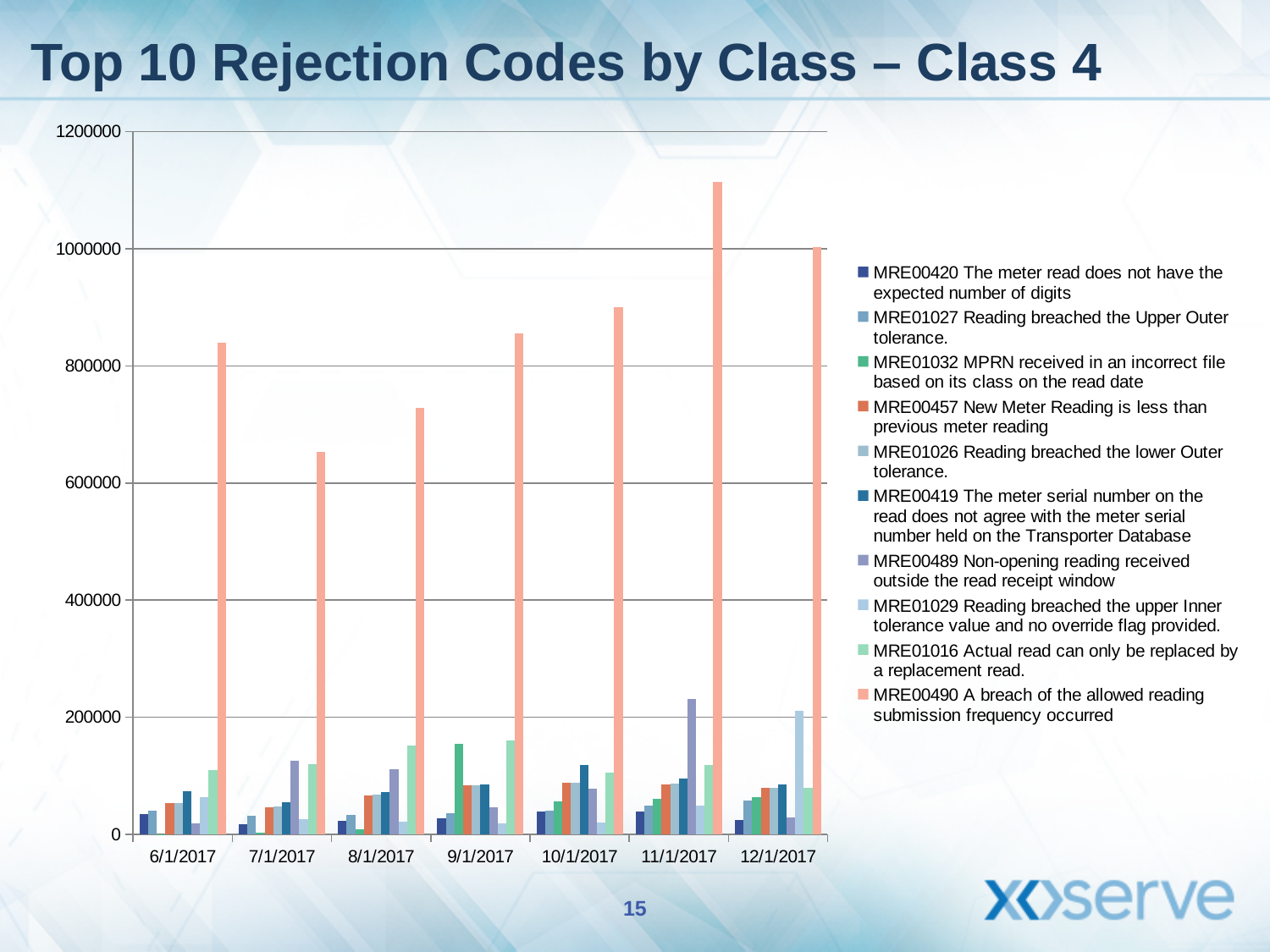
Is the value for MRE00490 on 7/1/2017 greater or less than 800000? less On which date is the value for MRE00490 (A breach of the allowed reading submission frequency occurred) highest? 11/1/2017 How many series does the chart's legend list? 10 How many dates are shown along the x axis of the chart? 7 Is the value for MRE00489 (Non-opening reading received outside the read receipt window) on 11/1/2017 greater or less than 200000? greater Is the value for MRE00490 on 10/1/2017 greater or less than 800000? greater Which is larger: the value for MRE00490 on 11/1/2017 or on 8/1/2017? 11/1/2017 On which date is the value for MRE00490 (A breach of the allowed reading submission frequency occurred) lowest? 7/1/2017 What kind of chart is shown on the slide? bar chart What is the title of the slide containing the chart? Top 10 Rejection Codes by Class – Class 4 Does the value for MRE00490 rise or fall from 6/1/2017 to 7/1/2017? fall